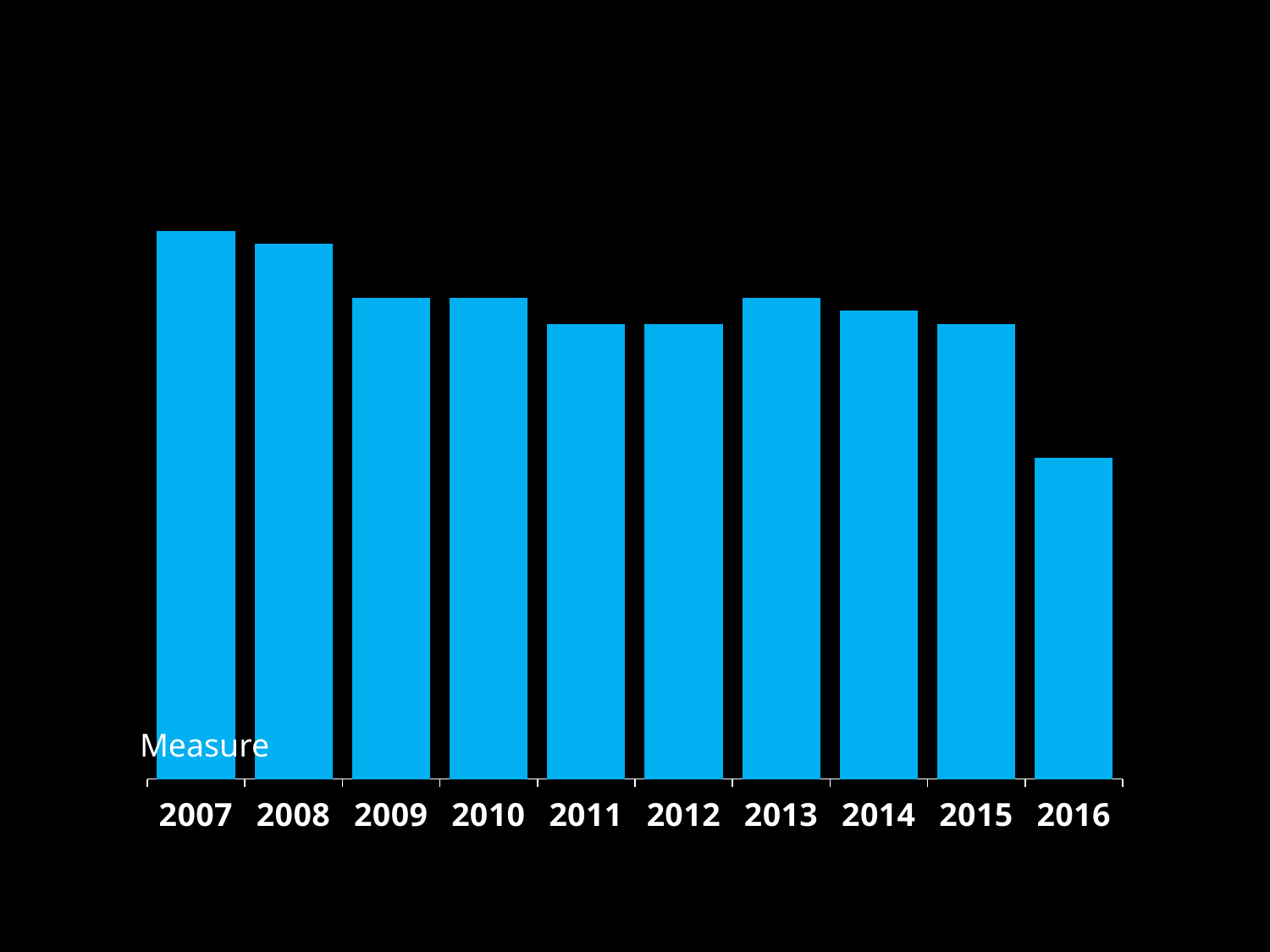
Do the values generally rise or fall from 2007 to 2016? fall Which year has the lowest bar in the chart? 2016 What kind of chart is shown on the slide? bar chart Which year has the larger value, 2008 or 2013? 2008 How many years are shown on the x axis of the chart? 10 What colour are the bars in the chart? blue Which year has the larger value, 2015 or 2016? 2015 Which year has the larger value, 2008 or 2009? 2008 Which year has the highest bar in the chart? 2007